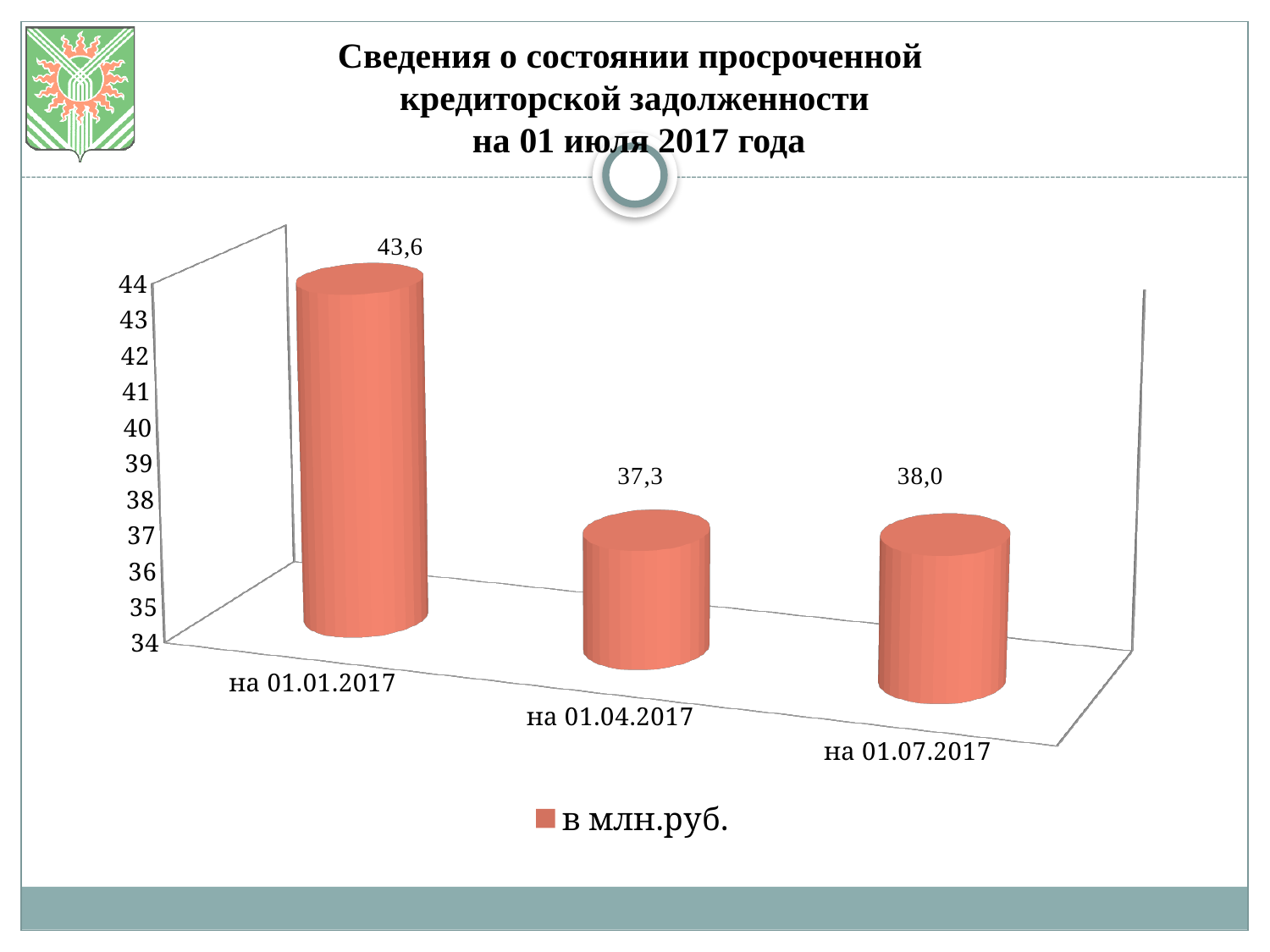
How many dates are shown on the chart? 3 Which date has the highest value? на 01.01.2017 What kind of chart is shown on the slide? bar chart What is the value for на 01.04.2017? 37,3 What is the value for на 01.07.2017? 38,0 What is the legend entry of the chart? в млн.руб. What is the difference between the values for на 01.01.2017 and на 01.04.2017? 6,3 Which is larger, the value for на 01.01.2017 or the value for на 01.07.2017? на 01.01.2017 What is the difference between the values for на 01.07.2017 and на 01.04.2017? 0,7 What is the value for на 01.01.2017? 43,6 Is the value for на 01.01.2017 greater or less than 40? greater Which date has the lowest value? на 01.04.2017